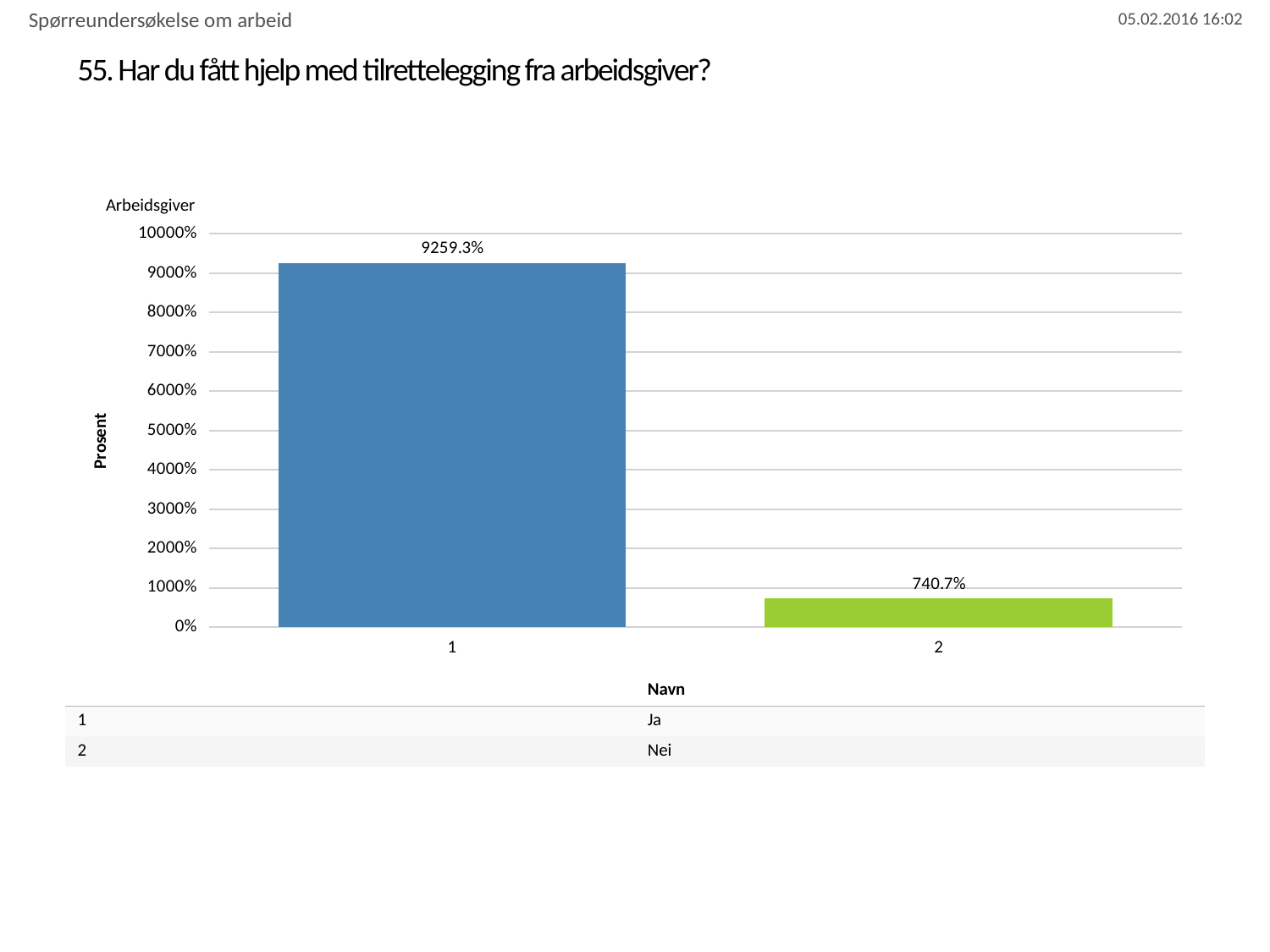
What kind of chart is shown? Bar chart Which category has the lowest value? 2 (Nei) What is the label of the y axis? Prosent How many categories are shown on the x axis? 2 What is the value for category 1 (Ja)? 9259.3% Which category has the highest value? 1 (Ja) Is the value for category 2 greater or less than 1000%? less What is the title of the chart? Arbeidsgiver Which is larger, the value for category 1 or category 2? Category 1 Is the value for category 1 greater or less than 9000%? greater What is the value for category 2 (Nei)? 740.7% What is the difference between the values for category 1 and category 2? 8518.6%